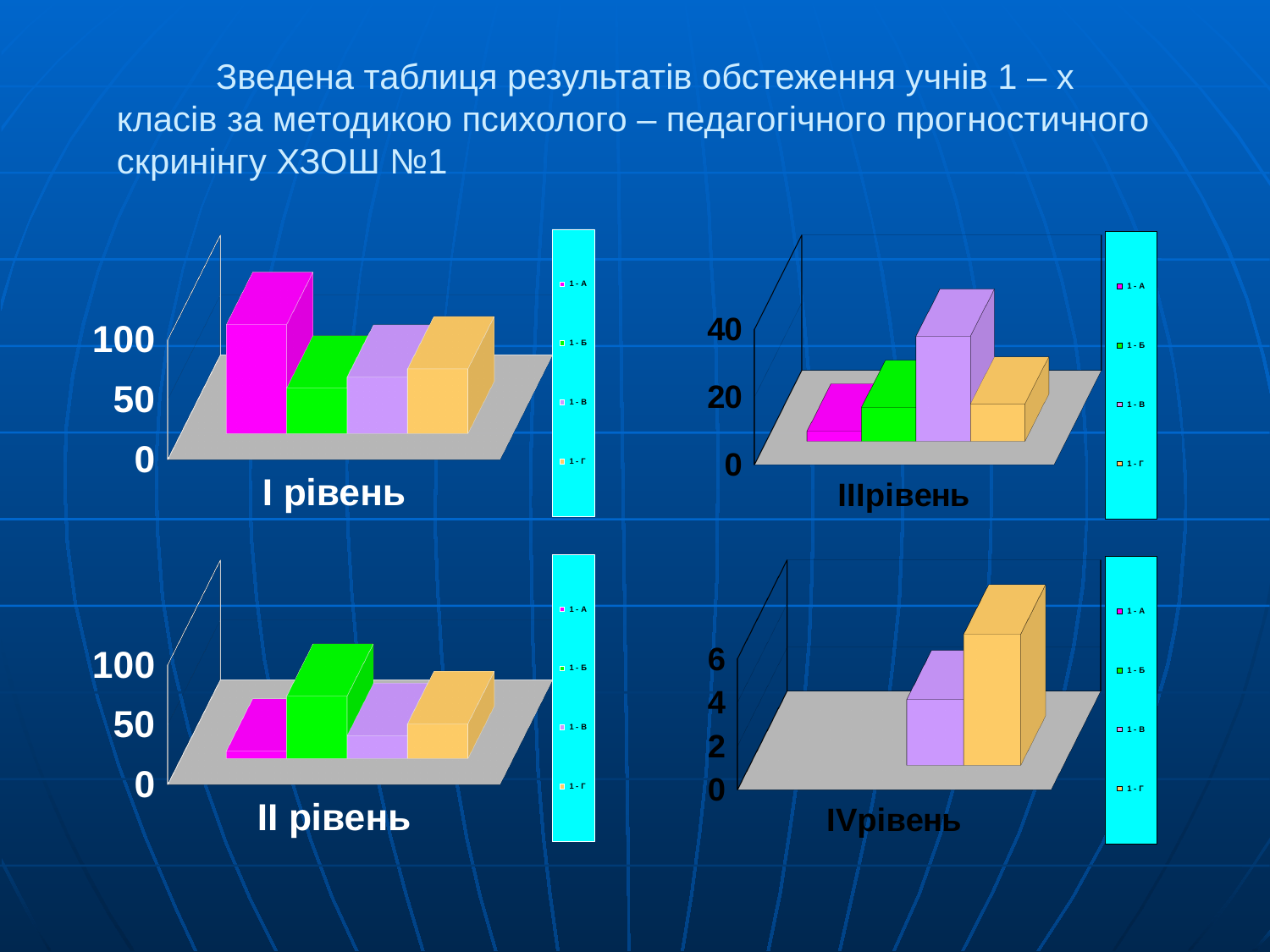
In the "І рівень" chart, which series has the highest value? 1-А In the "ІІ рівень" chart, is the value for 1-В greater or less than 50? less In the "ІVрівень" chart, which series has the highest value? 1-Г In the "І рівень" chart, is the value for 1-А greater or less than 50? greater In the "ІVрівень" chart, how many series have a visible bar? 2 In the "ІІ рівень" chart, which series has the lowest value? 1-А In the "ІVрівень" chart, is the value for 1-Г greater or less than 4? greater In the "ІІ рівень" chart, which is larger, the value for 1-Б or the value for 1-В? 1-Б In the "ІІ рівень" chart, which series has the highest value? 1-Б How many series does the legend of the "ІІ рівень" chart list? 4 What kind of chart is the "І рівень" chart? bar chart